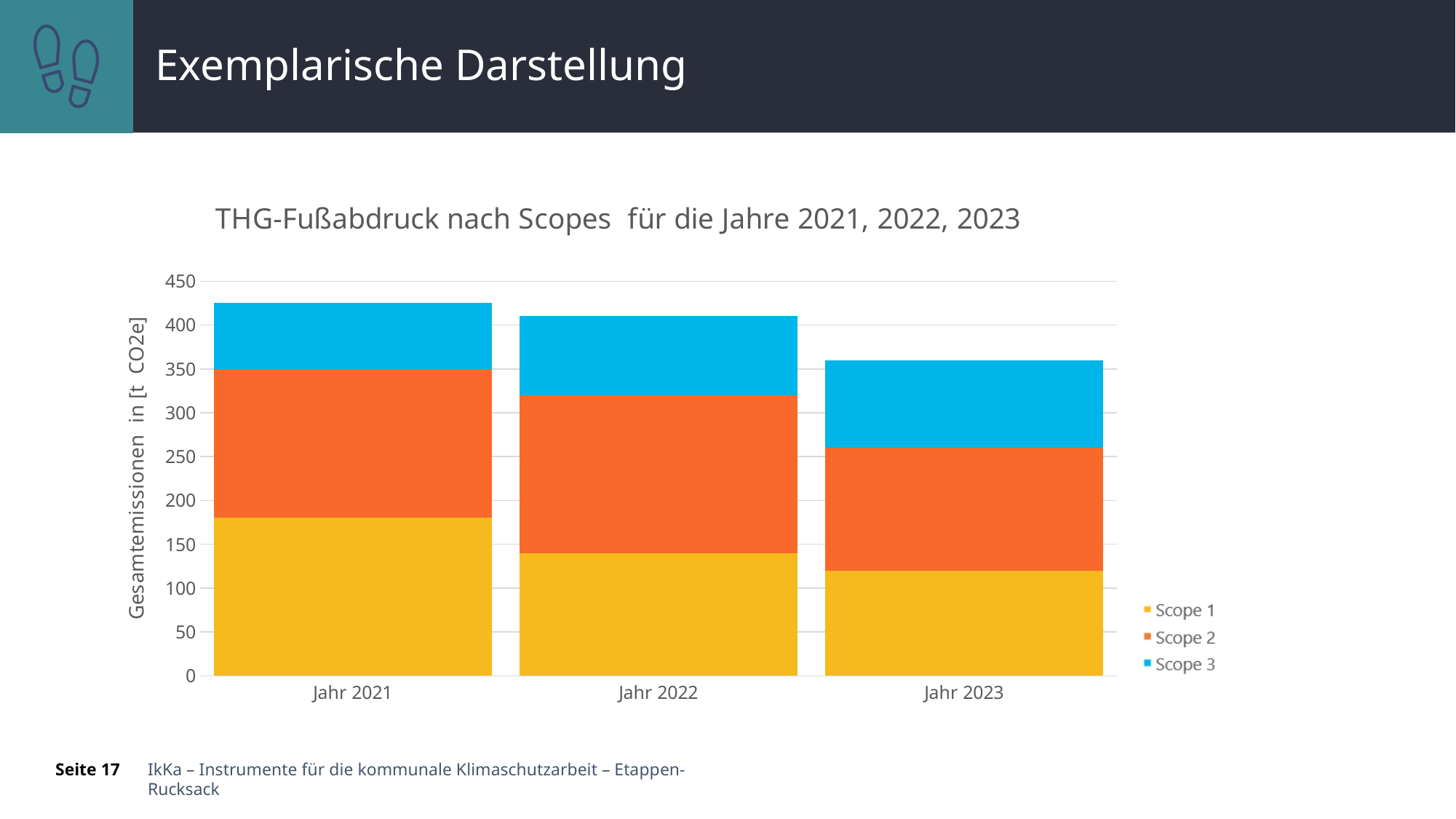
Is the total stacked bar for Jahr 2023 greater or less than 400? less What kind of chart is shown on the slide? Stacked bar chart What is the title of the chart? THG-Fußabdruck nach Scopes für die Jahre 2021, 2022, 2023 Which year has the highest total stacked bar? Jahr 2021 Is the total stacked bar for Jahr 2021 greater or less than 400? greater Do the total emissions rise or fall from Jahr 2021 to Jahr 2023? fall Is the Scope 1 value for Jahr 2023 greater or less than 150? less How many series does the legend list? 3 Which is larger, the Scope 1 value for Jahr 2021 or for Jahr 2023? Jahr 2021 How many years (categories) are shown on the x axis? 3 Which year has the lowest total stacked bar? Jahr 2023